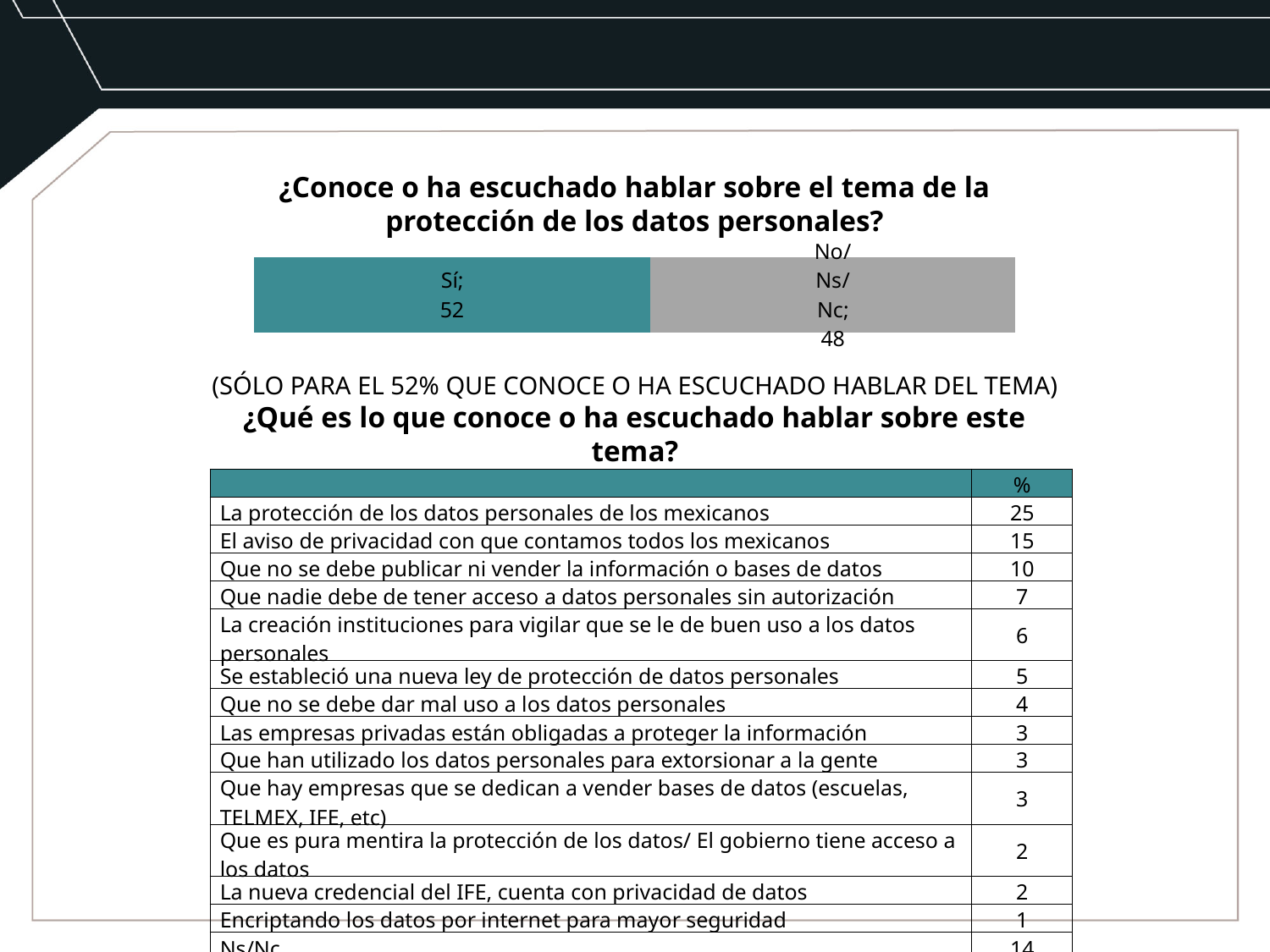
What is the total of the two segments in the stacked bar? 100 What colour is the "Sí" segment of the bar? Teal What kind of chart is shown on the slide? Bar chart What is the difference between the values for "Sí" and "No/Ns/Nc" in the chart? 4 Which category has the lowest value in the chart? No/Ns/Nc What is the value for "No/Ns/Nc" in the chart? 48 Which category has the highest value in the chart? Sí What is the title of the chart? ¿Conoce o ha escuchado hablar sobre el tema de la protección de los datos personales? How many categories are shown in the chart? 2 Which segment of the chart has the higher value, "Sí" or "No/Ns/Nc"? Sí What is the value for "Sí" in the chart? 52